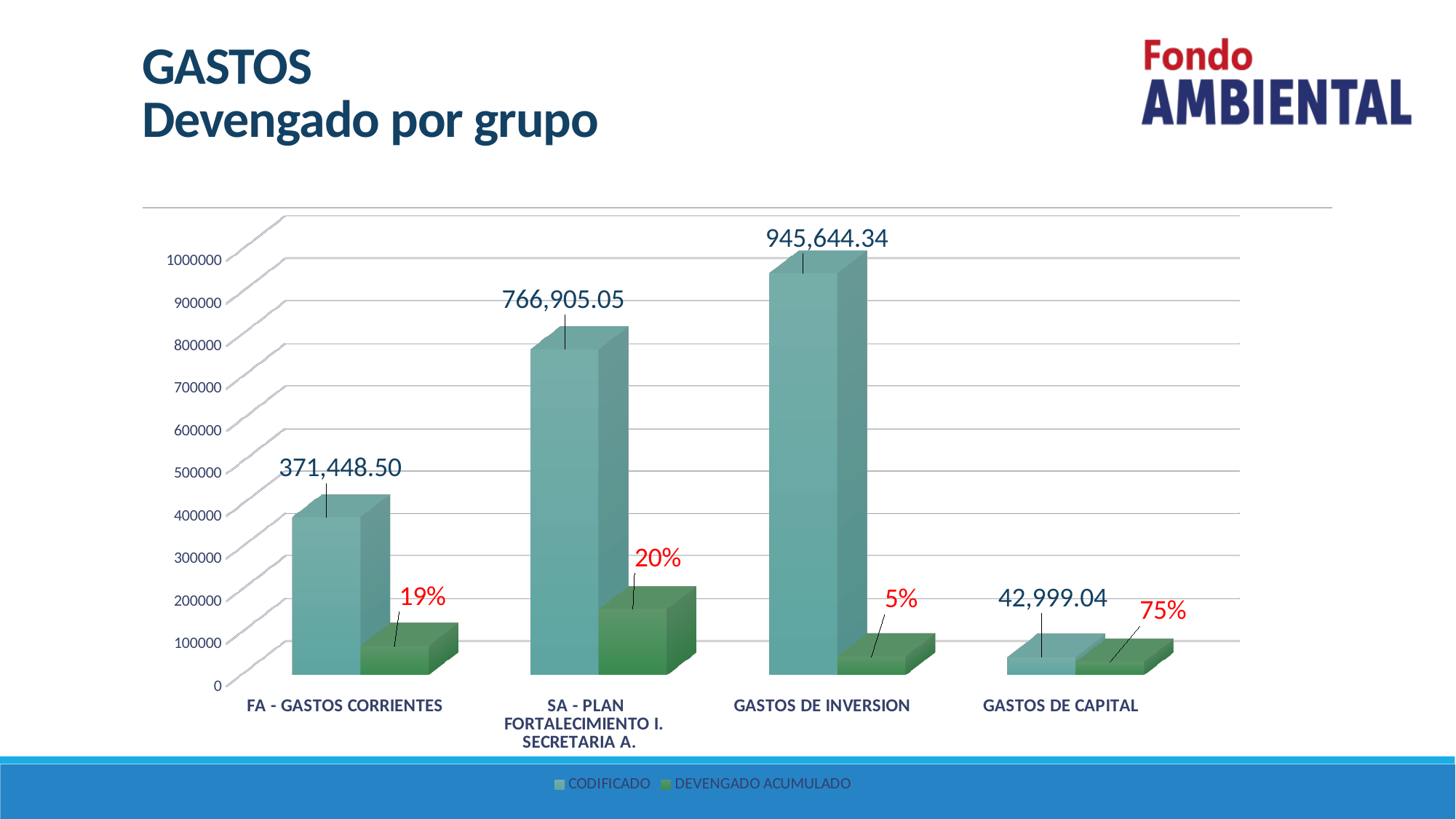
What percentage label is shown on the DEVENGADO ACUMULADO bar for GASTOS DE INVERSION? 5% How many series does the legend list? 2 What is the CODIFICADO value for SA - PLAN FORTALECIMIENTO I. SECRETARIA A.? 766,905.05 Which category has the lowest CODIFICADO value? GASTOS DE CAPITAL What percentage label is shown on the DEVENGADO ACUMULADO bar for GASTOS DE CAPITAL? 75% How many categories are shown on the x axis? 4 What is the difference between the CODIFICADO values for GASTOS DE INVERSION and SA - PLAN FORTALECIMIENTO I. SECRETARIA A.? 178,739.29 What is the CODIFICADO value for GASTOS DE INVERSION? 945,644.34 Is the CODIFICADO value for FA - GASTOS CORRIENTES greater or less than 400000? less What is the CODIFICADO value for GASTOS DE CAPITAL? 42,999.04 What is the CODIFICADO value for FA - GASTOS CORRIENTES? 371,448.50 Which category has the highest CODIFICADO value? GASTOS DE INVERSION